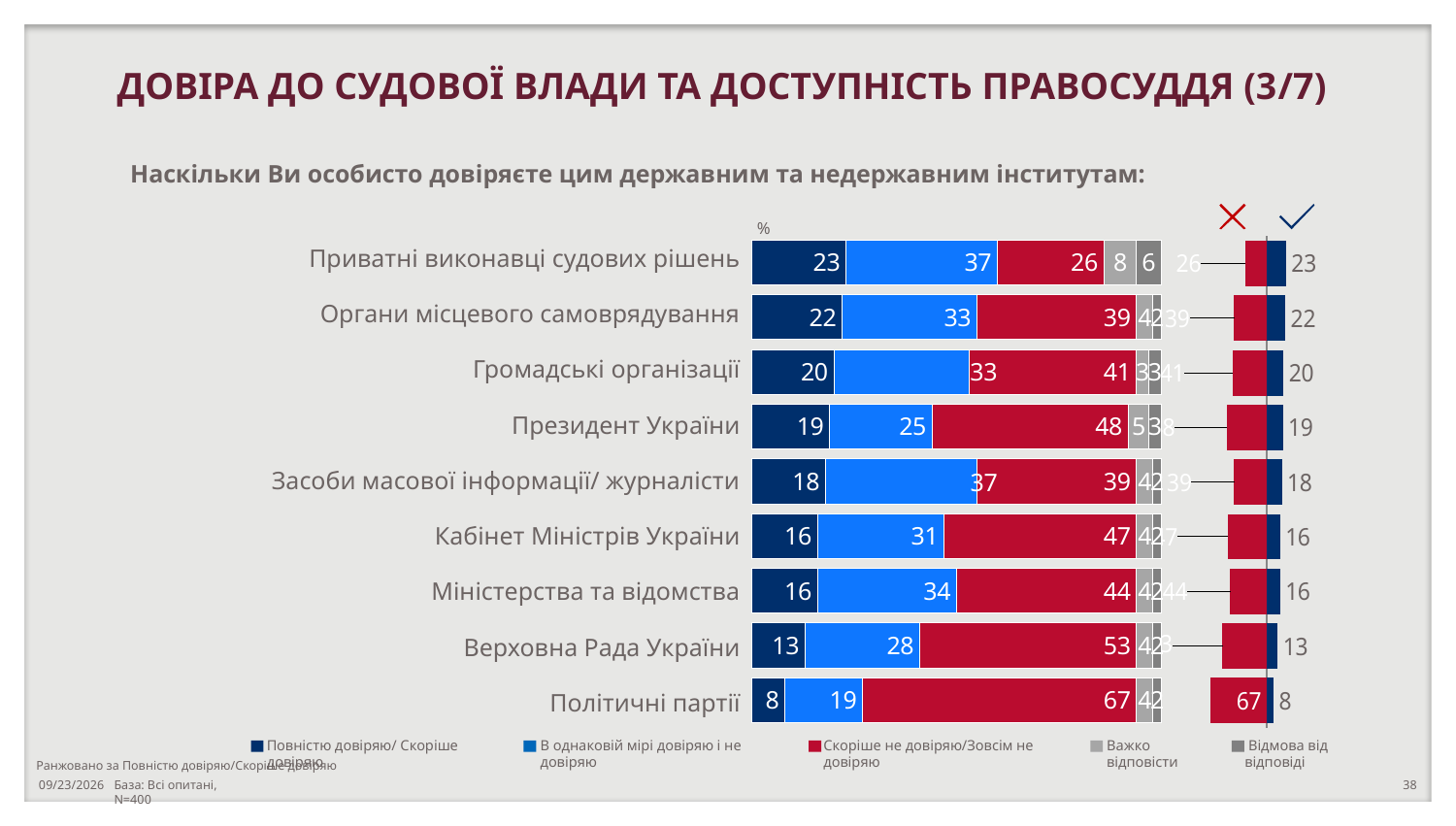
Which institution has the lowest value for 'Повністю довіряю/ Скоріше довіряю'? Політичні партії Which has a larger 'В однаковій мірі довіряю і не довіряю' value: 'Кабінет Міністрів України' or 'Міністерства та відомства'? Міністерства та відомства What is the difference between the 'Скоріше не довіряю/Зовсім не довіряю' values for 'Політичні партії' and 'Приватні виконавці судових рішень'? 41 What is the question text shown above the chart? Наскільки Ви особисто довіряєте цим державним та недержавним інститутам: What kind of chart is shown on the slide? Stacked bar chart What is the value of 'В однаковій мірі довіряю і не довіряю' for 'Президент України'? 25 Which institution has the highest value for 'Повністю довіряю/ Скоріше довіряю'? Приватні виконавці судових рішень How many institutions (categories) are listed in the chart? 9 What is the value of 'Скоріше не довіряю/Зовсім не довіряю' for 'Політичні партії'? 67 What is the value of 'Скоріше не довіряю/Зовсім не довіряю' for 'Верховна Рада України'? 53 How many series does the legend list? 5 What is the value of 'Повністю довіряю/ Скоріше довіряю' for 'Приватні виконавці судових рішень'? 23